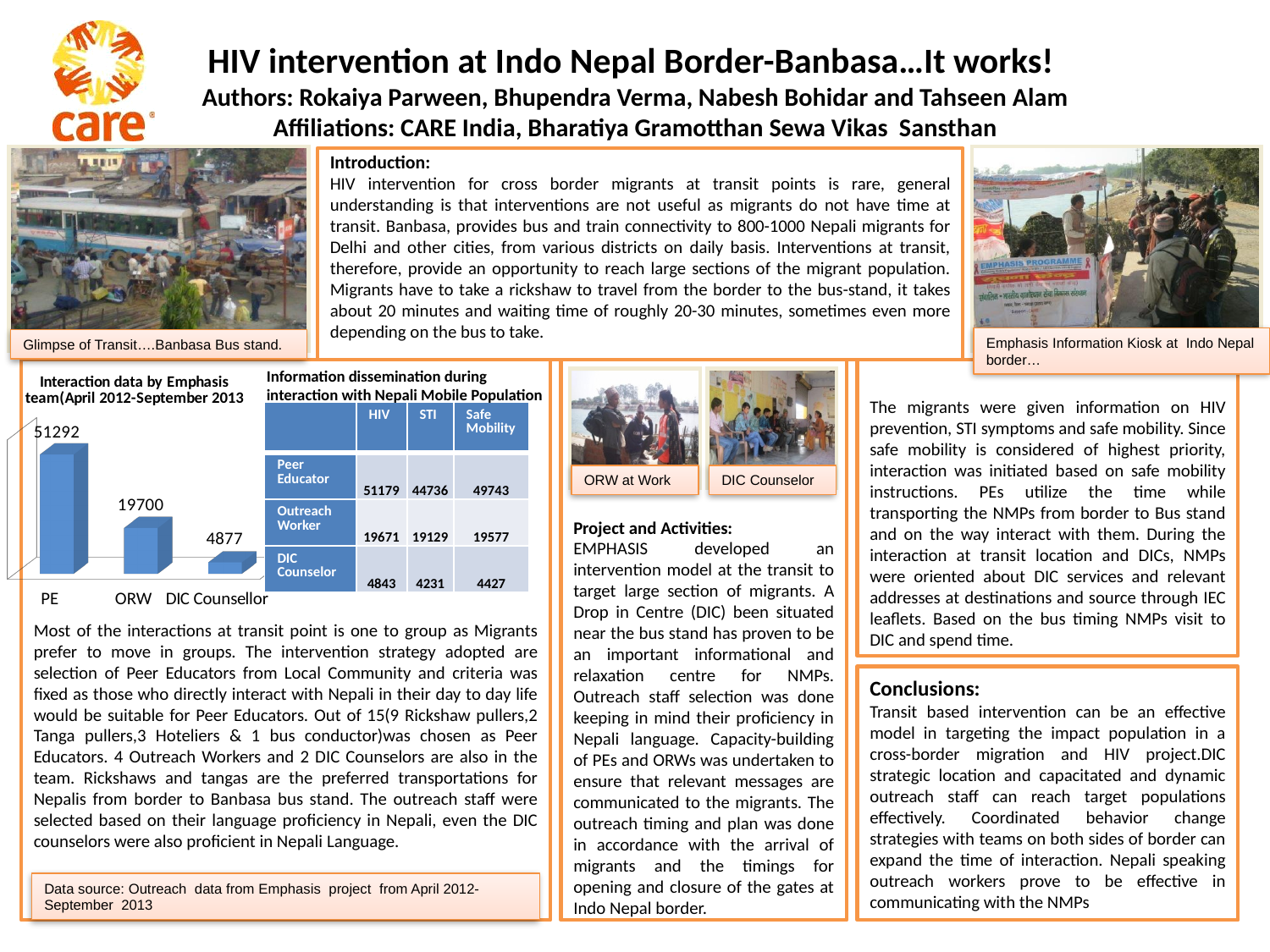
Which category has the lowest value in the 'Interaction data by Emphasis team' chart? DIC Counsellor What is the difference between the ORW and DIC Counsellor values in the 'Interaction data by Emphasis team' chart? 14823 What is the value for DIC Counsellor in the 'Interaction data by Emphasis team' chart? 4877 What is the difference between the PE and ORW values in the 'Interaction data by Emphasis team' chart? 31592 What is the value for PE in the 'Interaction data by Emphasis team' chart? 51292 What is the value for ORW in the 'Interaction data by Emphasis team' chart? 19700 How many categories are shown in the 'Interaction data by Emphasis team' chart? 3 What period does the title of the 'Interaction data by Emphasis team' chart cover? April 2012-September 2013 In the 'Interaction data by Emphasis team' chart, which is larger, the value for ORW or the value for DIC Counsellor? ORW Do the values in the 'Interaction data by Emphasis team' chart rise or fall from left to right along the x axis? Fall What kind of chart is the 'Interaction data by Emphasis team' chart? Bar chart Which category has the highest value in the 'Interaction data by Emphasis team' chart? PE